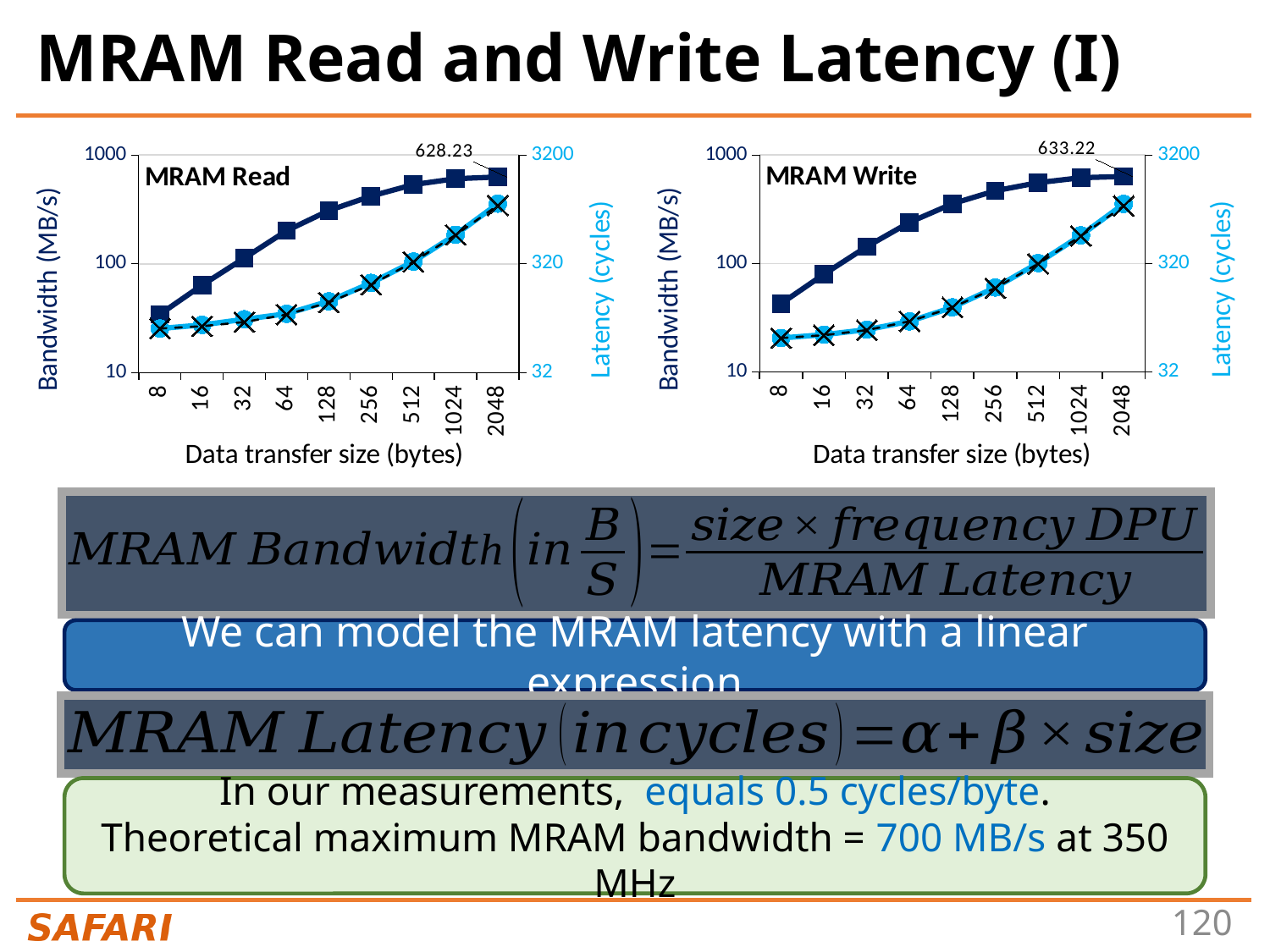
In the MRAM Read chart, is the latency at 8 bytes greater or less than 320 cycles? less In the MRAM Write chart, what is the bandwidth value labelled at a data transfer size of 2048 bytes? 633.22 Which chart shows the larger labelled bandwidth at 2048 bytes, MRAM Read or MRAM Write? MRAM Write In the MRAM Write chart, is the bandwidth at 512 bytes greater or less than 100 MB/s? greater In the MRAM Read chart, how many data transfer sizes are shown on the x axis? 9 In the MRAM Read chart, what is the bandwidth value labelled at a data transfer size of 2048 bytes? 628.23 In the MRAM Read chart, at which data transfer size is the bandwidth highest? 2048 What kind of chart is the MRAM Write chart? line chart In the MRAM Read chart, is the bandwidth at 8 bytes greater or less than 100 MB/s? less In the MRAM Read chart, does the latency rise or fall as the data transfer size increases? rises In the MRAM Write chart, does the bandwidth rise or fall as the data transfer size increases? rises What is the difference between the labelled bandwidth at 2048 bytes in the MRAM Write chart and in the MRAM Read chart? 4.99